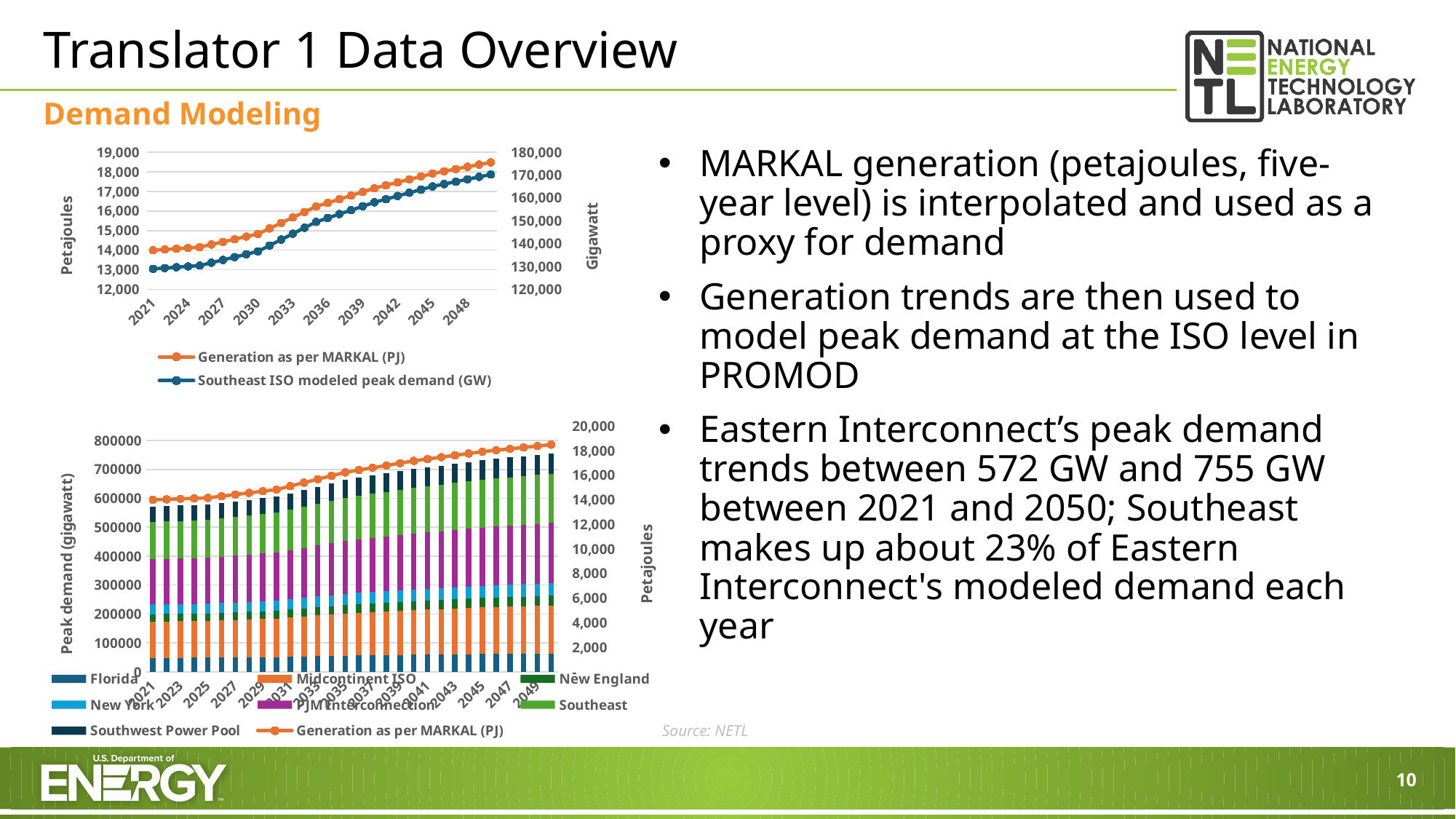
In the bottom chart, does the total height of the stacked bars rise or fall from 2021 to 2049? rise In the top chart, does the Southeast ISO modeled peak demand (GW) series rise or fall over the years shown? rise In the top chart, is the Southeast ISO modeled peak demand (GW) in 2048 greater or less than 160,000? greater How many entries does the legend of the bottom chart list? 8 How many series does the legend of the top chart list? 2 In the bottom chart, is the total stacked peak demand in 2021 greater or less than 600000? less In the bottom chart, is the total stacked peak demand in 2049 greater or less than 700000? greater In the top chart, what is the label of the right-hand vertical axis? Gigawatt What kind of chart is the bottom chart on the slide? combination bar and line chart (stacked bars with a line) What kind of chart is the top chart on the slide? line chart In the top chart, does the Generation as per MARKAL (PJ) series rise or fall from 2021 to 2050? rise